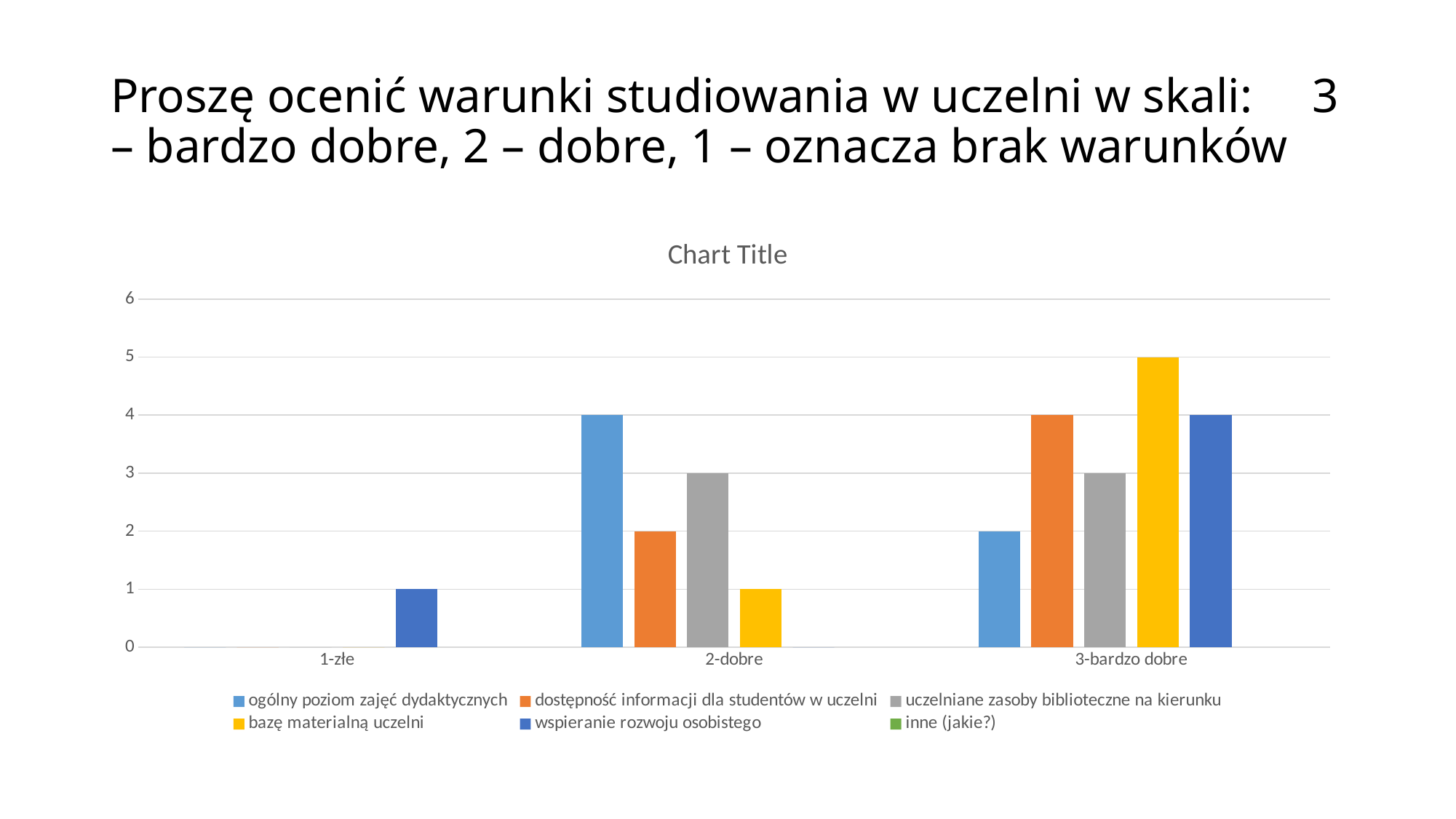
What type of chart is shown on the slide? bar chart What is the value for 'wspieranie rozwoju osobistego' in the '1-złe' category? 1 What is the value for 'bazę materialną uczelni' in the '3-bardzo dobre' category? 5 What is the difference between 'bazę materialną uczelni' in '3-bardzo dobre' and in '2-dobre'? 4 How many series does the legend list? 6 Which series has the highest value in the '3-bardzo dobre' category? bazę materialną uczelni Which is larger: 'dostępność informacji dla studentów w uczelni' in '2-dobre' or in '3-bardzo dobre'? 3-bardzo dobre Does the value for 'ogólny poziom zajęć dydaktycznych' rise or fall from '2-dobre' to '3-bardzo dobre'? fall How many categories are shown on the x axis? 3 What is the value for 'ogólny poziom zajęć dydaktycznych' in the '2-dobre' category? 4 What is the title shown above the chart? Chart Title